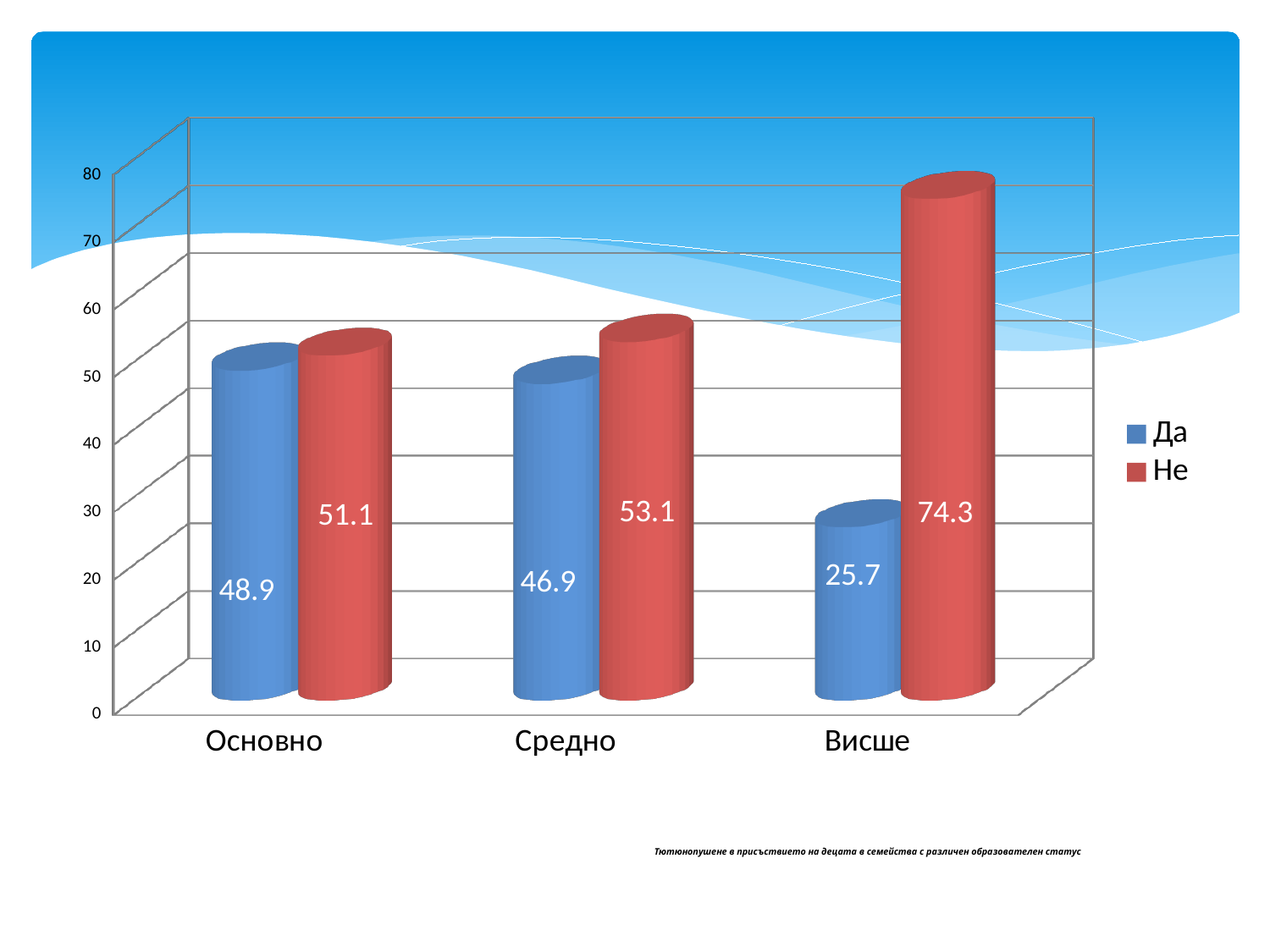
Which is larger in the "Основно" category, "Да" or "Не"? Не Which category has the lowest value for "Да"? Висше What kind of chart is shown on the slide? bar chart How many categories are shown on the x axis? 3 What is the difference between the "Не" and "Да" values in the "Висше" category? 48.6 Which category has the highest value for "Не"? Висше How many series does the legend list? 2 Is the value for "Не" in "Висше" greater or less than 70? greater What is the value for "Не" in the "Средно" category? 53.1 What is the value for "Да" in the "Основно" category? 48.9 What is the difference between the "Не" and "Да" values in the "Средно" category? 6.2 What is the value for "Не" in the "Висше" category? 74.3